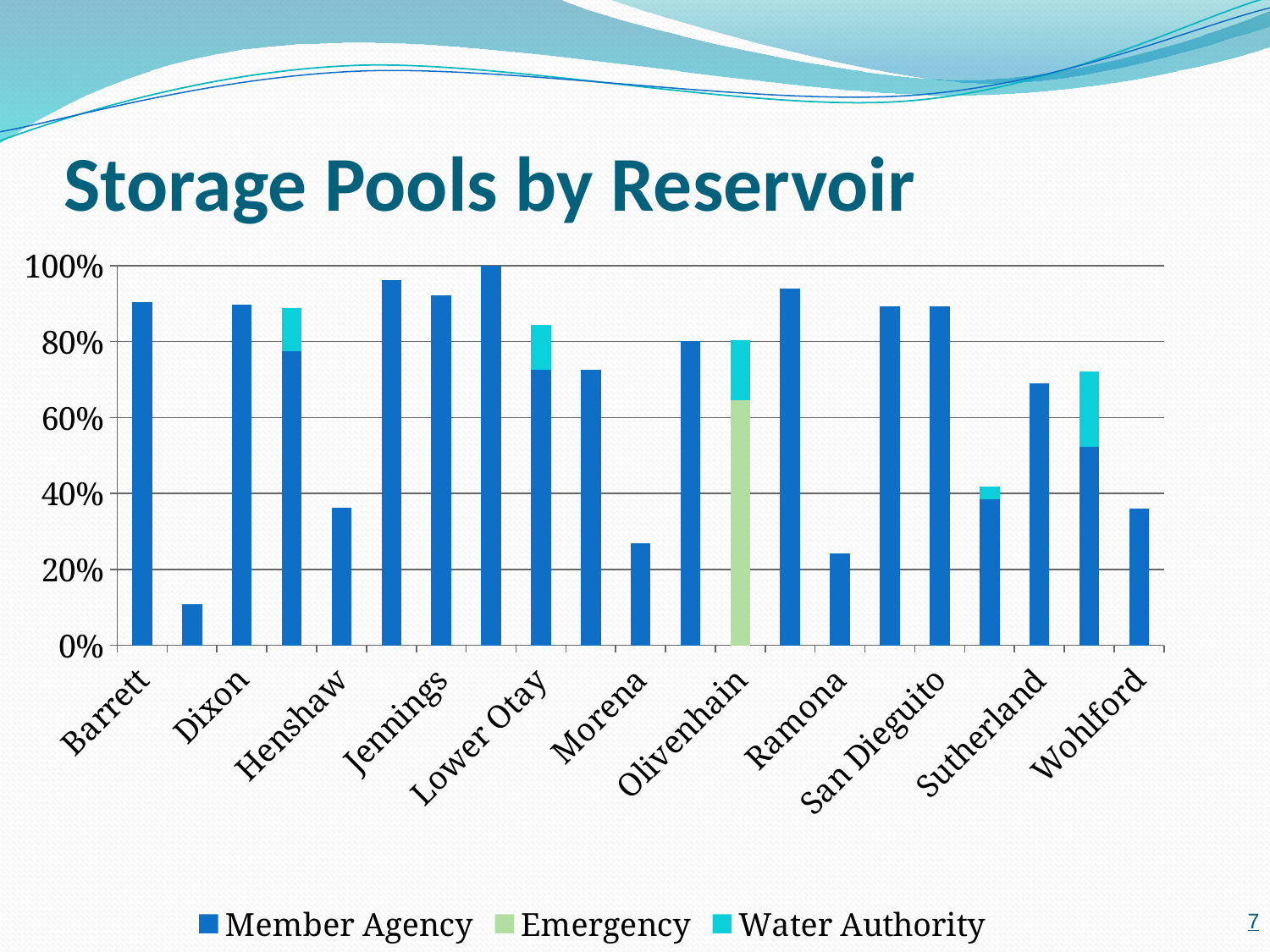
How many series does the legend list? 3 Which is larger, the value for Jennings or the value for Ramona? Jennings Is the value for Wohlford greater or less than 40%? less Is the value for Jennings greater or less than 80%? greater Is the value for Sutherland greater or less than 60%? greater Which reservoir is the only one with an Emergency segment in its bar? Olivenhain What kind of chart is shown on the slide? Stacked bar chart What is the title of the chart? Storage Pools by Reservoir Which is larger, the value for Barrett or the value for Morena? Barrett